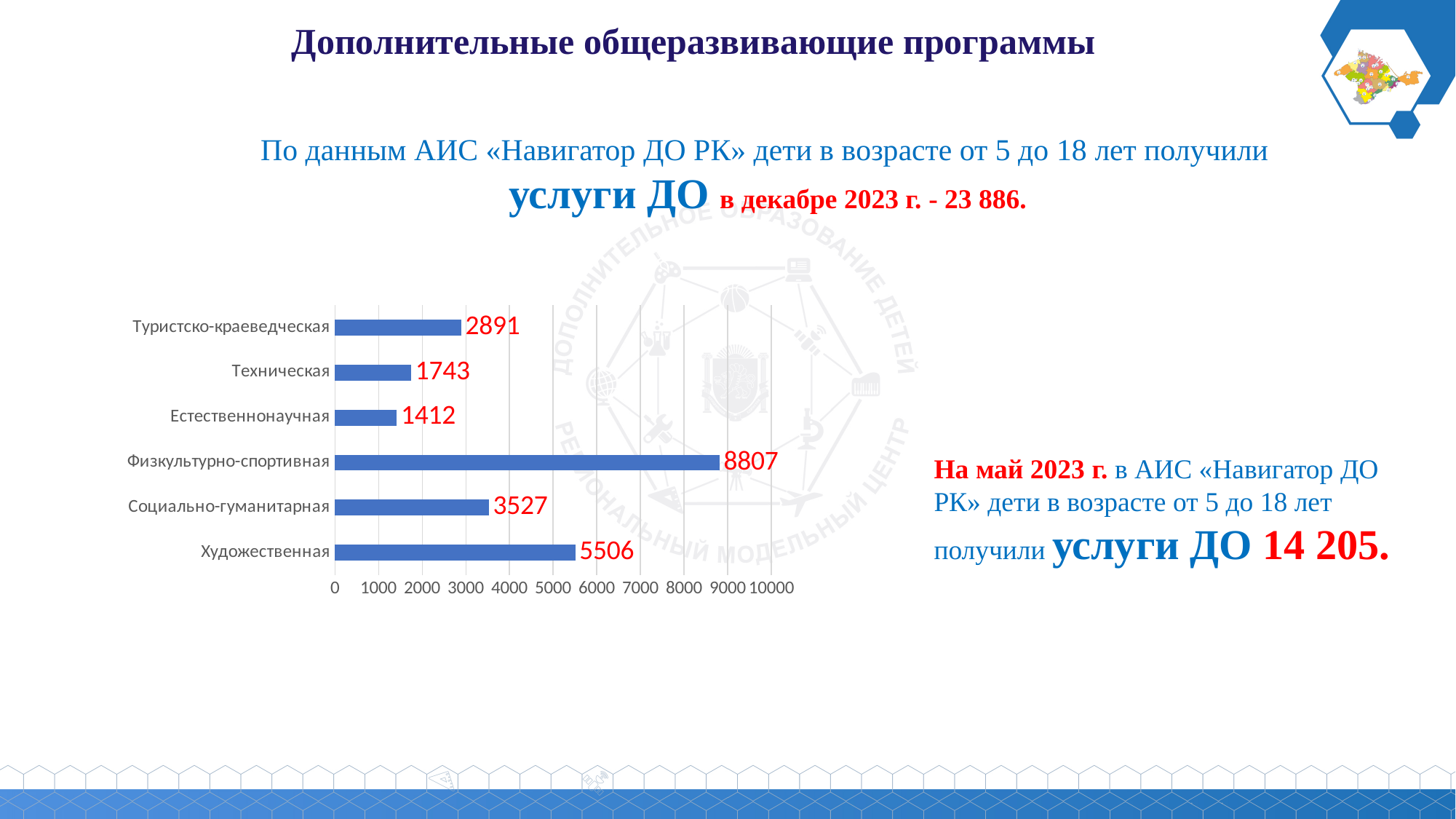
What is the value for Естественнонаучная? 1412 Which category has the highest value? Физкультурно-спортивная Which is larger, the value for Социально-гуманитарная or the value for Туристско-краеведческая? Социально-гуманитарная What is the value for Художественная? 5506 How many categories are shown in the chart? 6 What is the value for Туристско-краеведческая? 2891 Which category has the lowest value? Естественнонаучная What is the value for Физкультурно-спортивная? 8807 Is the value for Социально-гуманитарная greater or less than 3000? greater What kind of chart is shown on the slide? bar chart What is the difference between the values for Техническая and Естественнонаучная? 331 What is the difference between the values for Физкультурно-спортивная and Художественная? 3301